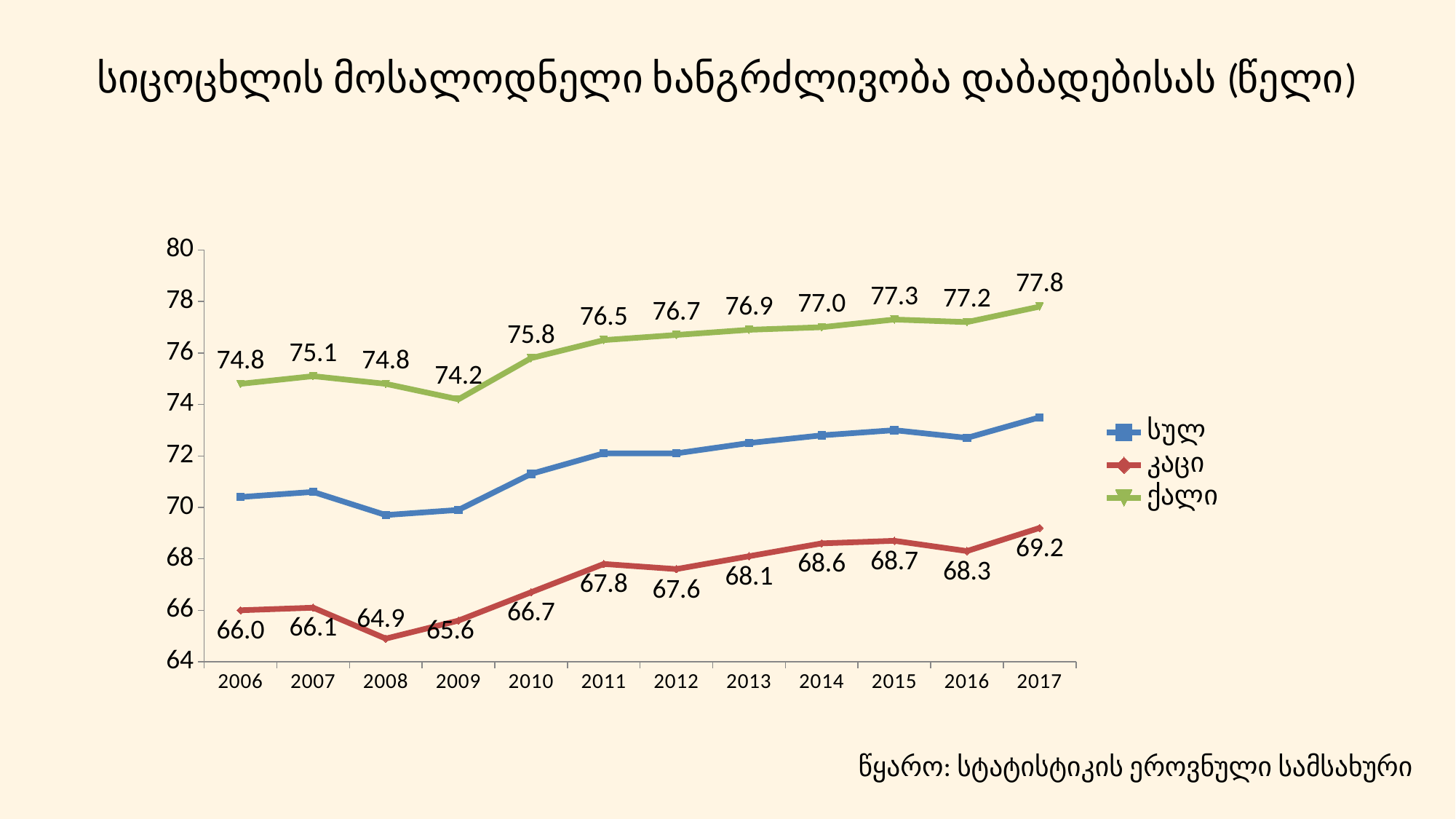
Which is larger for კაცი: the value in 2011 or the value in 2012? 2011 What is the value for ქალი in 2017? 77.8 In which year is the value for ქალი lowest? 2009 In which year is the value for კაცი highest? 2017 What kind of chart is shown on the slide? line chart Is the value for სულ in 2008 greater or less than 72? less Does the value for ქალი rise or fall from 2009 to 2015? rise Is the value for სულ in 2017 greater or less than 72? greater How many years are shown on the x axis? 12 What is the value for კაცი in 2008? 64.9 How many series does the legend list? 3 What is the difference between the ქალი and კაცი values in 2017? 8.6